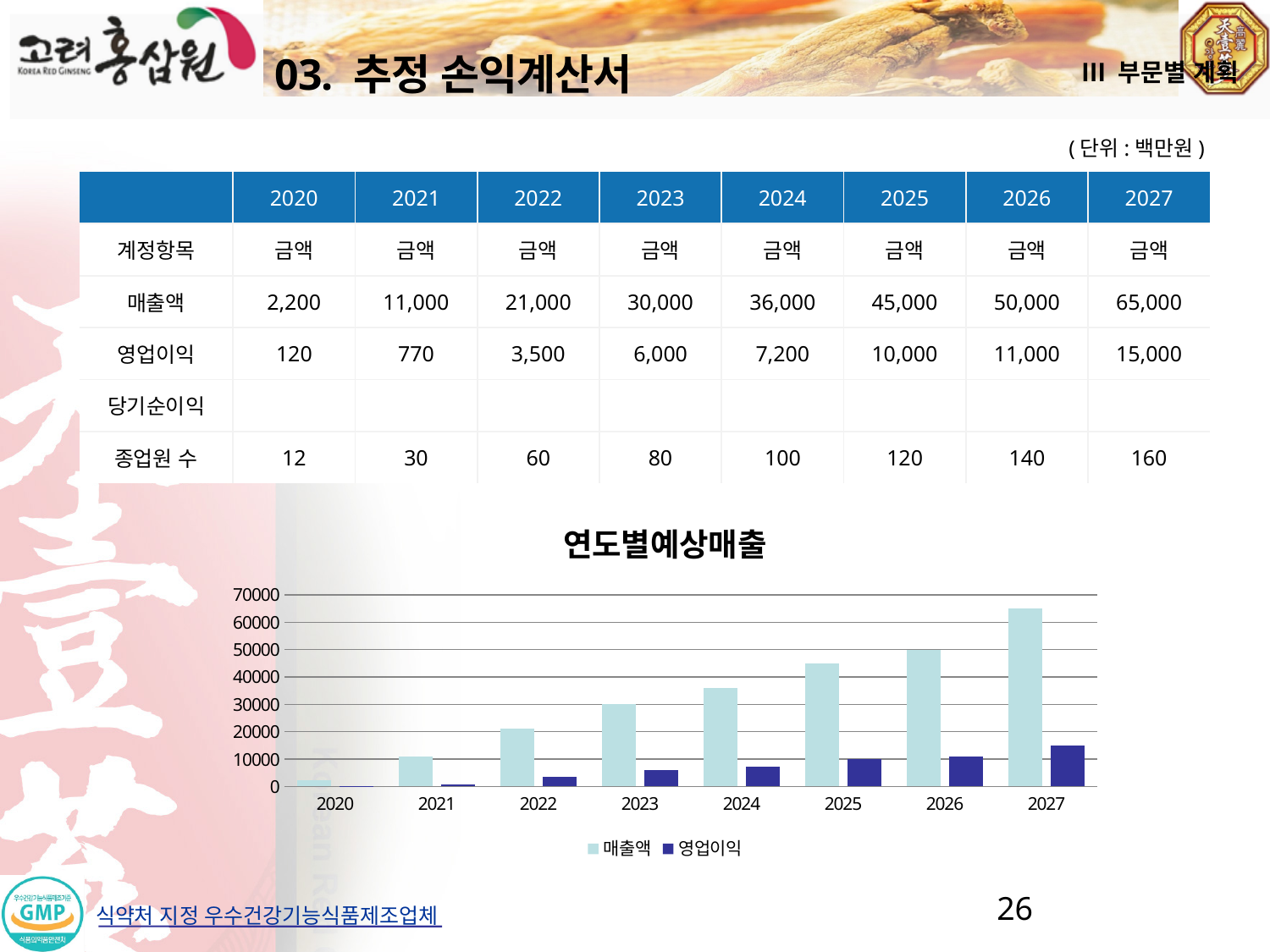
Which series are listed in the legend of the 연도별예상매출 chart? 매출액 and 영업이익 In the 연도별예상매출 chart, is the 매출액 value for 2024 greater or less than 30000? greater How many series does the legend of the 연도별예상매출 chart list? 2 In the 연도별예상매출 chart, which is larger for 2026: 매출액 or 영업이익? 매출액 What kind of chart is shown under the title 연도별예상매출? bar chart How many years are shown on the x axis of the 연도별예상매출 chart? 8 In the 연도별예상매출 chart, which year has the highest 매출액 bar? 2027 In the 연도별예상매출 chart, which year has the lowest 매출액 bar? 2020 What is the title of the chart on the slide? 연도별예상매출 In the 연도별예상매출 chart, is the 영업이익 value for 2022 greater or less than 10000? less In the 연도별예상매출 chart, do the 매출액 bars rise or fall from 2020 to 2027? rise According to the table, what is the 매출액 value for 2027? 65,000